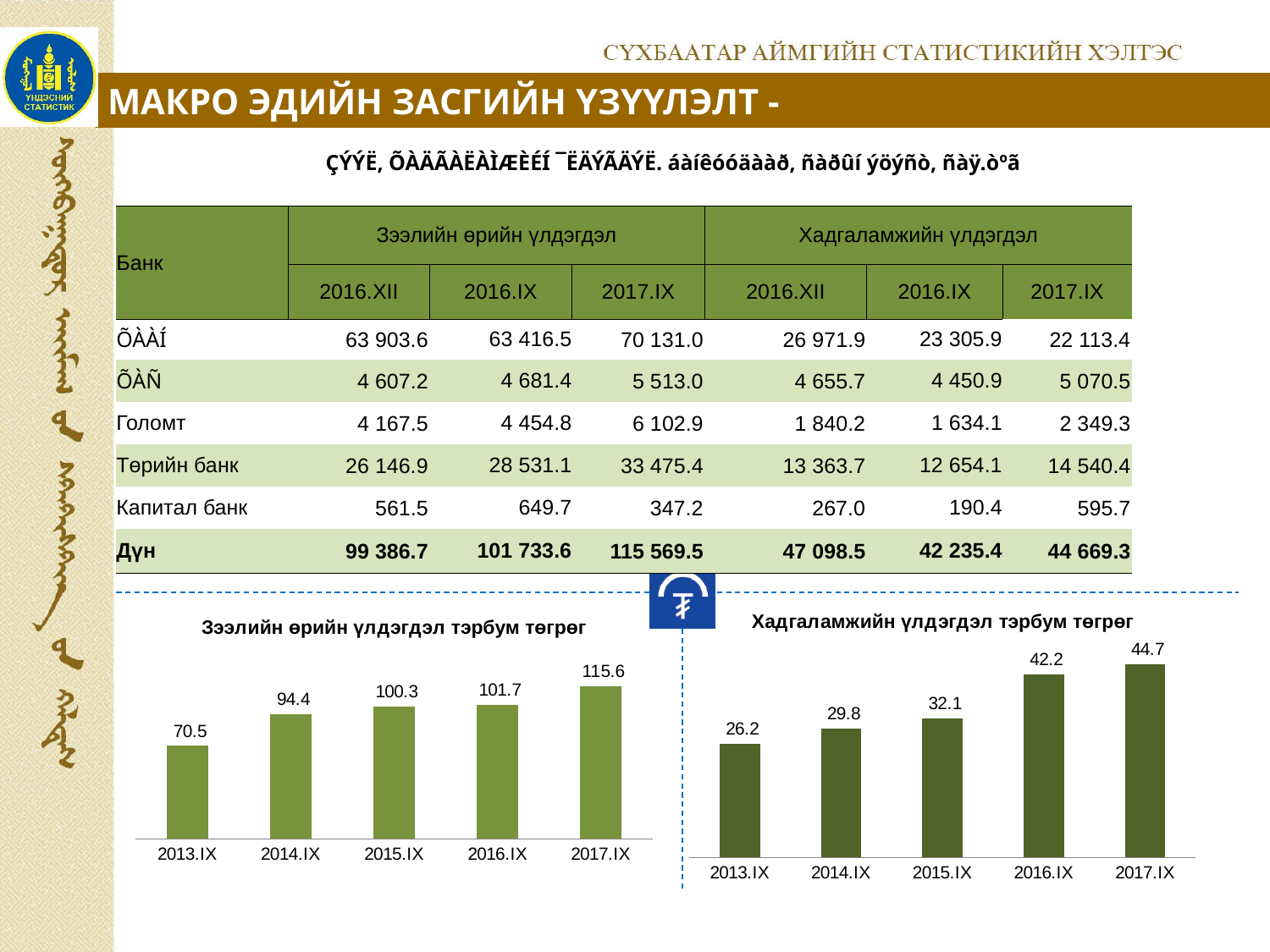
In the chart titled "Зээлийн өрийн үлдэгдэл тэрбум төгрөг", what is the difference between the values for 2017.IX and 2016.IX? 13.9 How many bars are in the chart titled "Зээлийн өрийн үлдэгдэл тэрбум төгрөг"? 5 In the chart titled "Зээлийн өрийн үлдэгдэл тэрбум төгрөг", which year has the highest value? 2017.IX In the chart titled "Хадгаламжийн үлдэгдэл тэрбум төгрөг", which is larger, the value for 2015.IX or 2016.IX? 2016.IX In the chart titled "Хадгаламжийн үлдэгдэл тэрбум төгрөг", what is the value for 2014.IX? 29.8 In the chart titled "Хадгаламжийн үлдэгдэл тэрбум төгрөг", what is the difference between the values for 2017.IX and 2013.IX? 18.5 In the chart titled "Зээлийн өрийн үлдэгдэл тэрбум төгрөг", what is the value for 2017.IX? 115.6 In the chart titled "Зээлийн өрийн үлдэгдэл тэрбум төгрөг", do the values rise or fall from 2013.IX to 2017.IX? Rise In the chart titled "Хадгаламжийн үлдэгдэл тэрбум төгрөг", which year has the lowest value? 2013.IX In the chart titled "Зээлийн өрийн үлдэгдэл тэрбум төгрөг", what is the value for 2013.IX? 70.5 In the chart titled "Хадгаламжийн үлдэгдэл тэрбум төгрөг", what is the value for 2016.IX? 42.2 What type of chart is the chart titled "Хадгаламжийн үлдэгдэл тэрбум төгрөг"? Bar chart